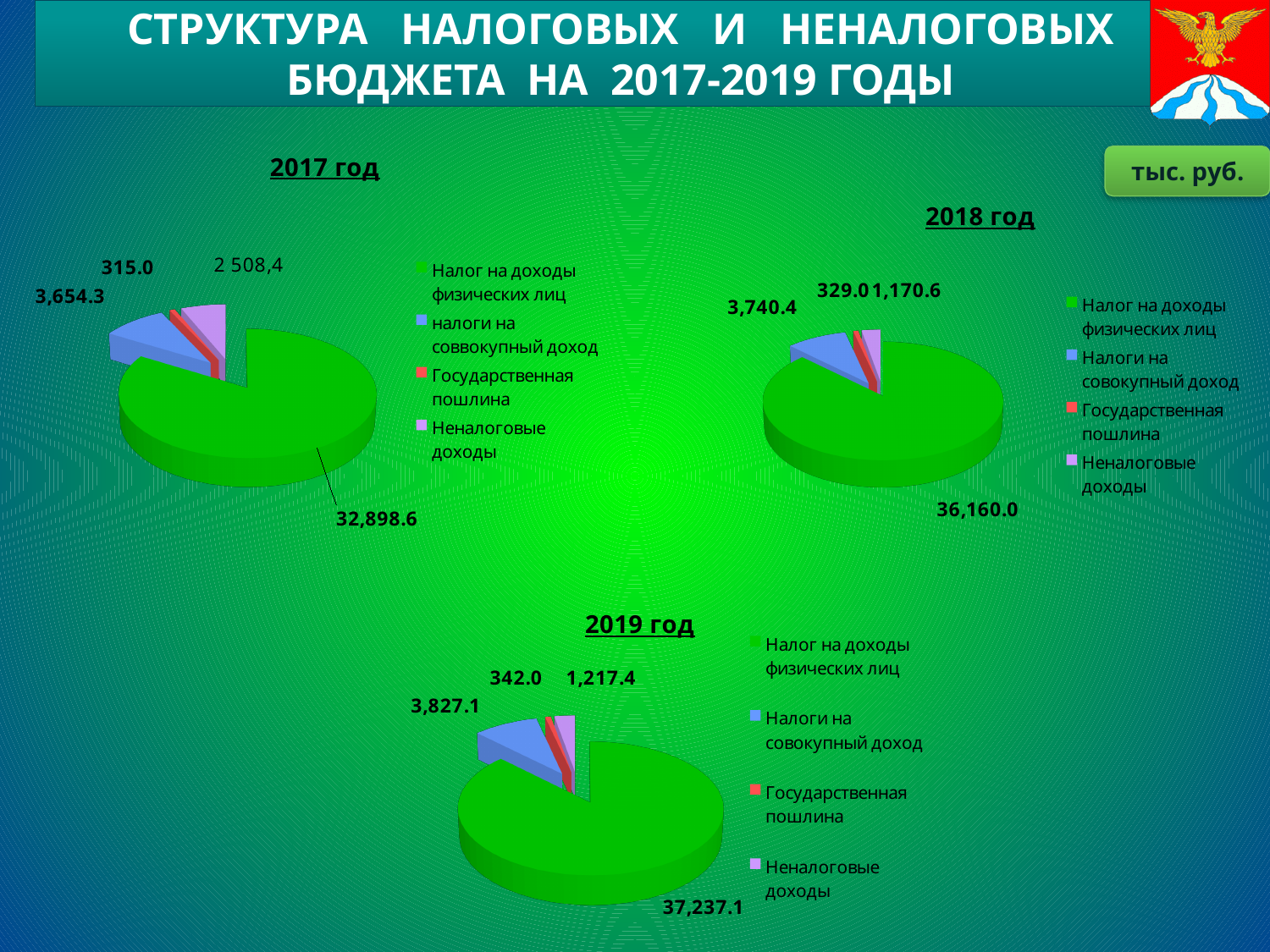
On the 2017 год chart, which is larger: Налоги на совокупный доход or Неналоговые доходы? Налоги на совокупный доход On the 2017 год chart, which category has the smallest value? Государственная пошлина On the 2018 год chart, what is the value for Налоги на совокупный доход? 3,740.4 On the 2018 год chart, which category has the largest value? Налог на доходы физических лиц On the 2019 год chart, what is the value for Государственная пошлина? 342.0 What unit of measurement is indicated on the slide for the charts? тыс. руб. What is the difference between the Государственная пошлина value on the 2018 год chart and on the 2017 год chart? 14.0 What is the difference between the Налог на доходы физических лиц value on the 2019 год chart and on the 2018 год chart? 1,077.1 How many slices does the 2019 год pie chart have? 4 What type of chart is used for 2018 год? Pie chart On the 2019 год chart, what is the value for Неналоговые доходы? 1,217.4 On the 2017 год chart, what is the value for Налог на доходы физических лиц? 32,898.6